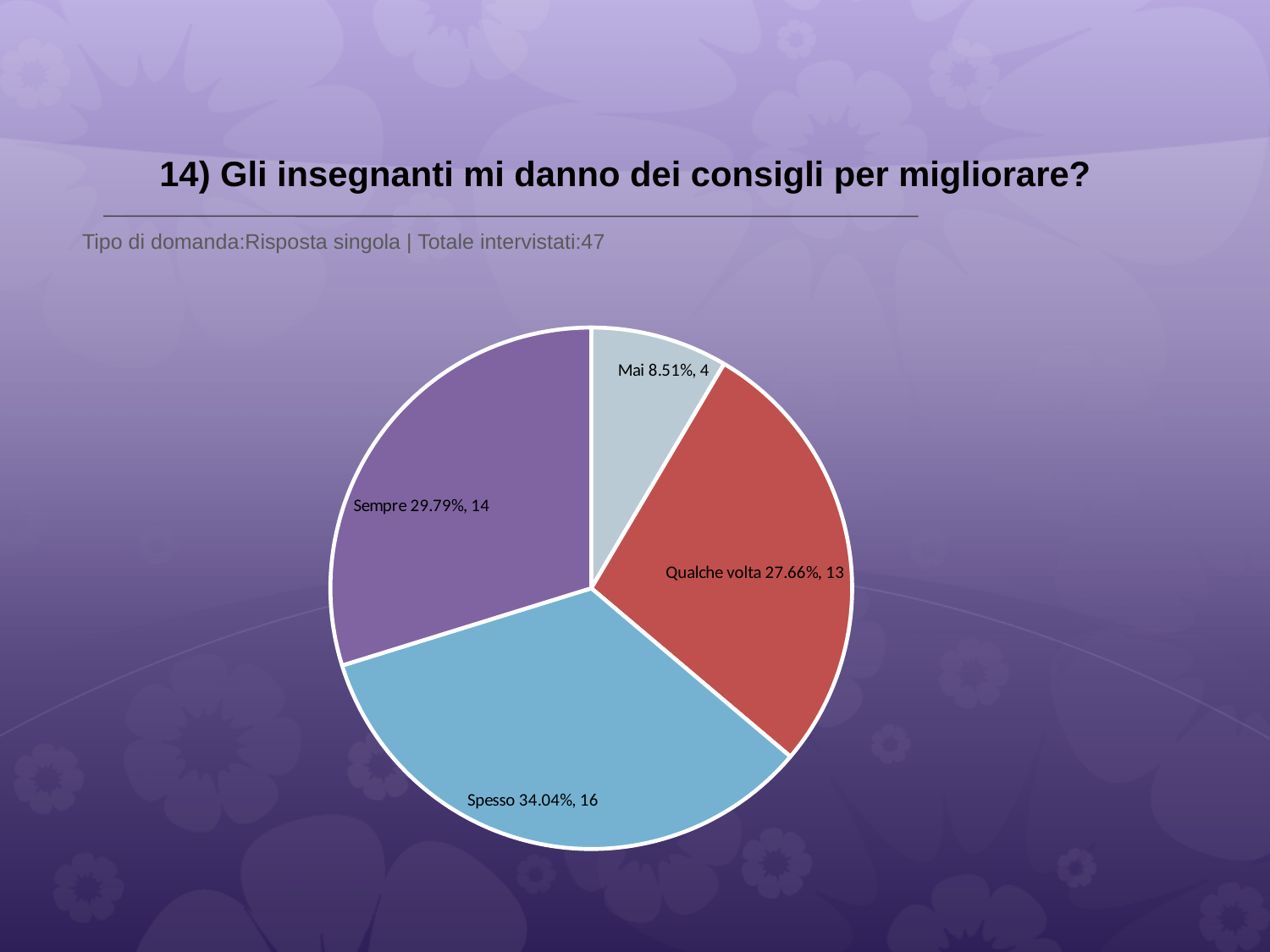
What is the title of the chart on the slide? 14) Gli insegnanti mi danno dei consigli per migliorare? What is the share of the pie for "Qualche volta"? 27.66% What percentage is shown for the "Spesso" slice? 34.04% What is the difference in respondent count between "Spesso" and "Mai"? 12 Which response has the smallest share of the pie? Mai Which has more respondents, "Sempre" or "Qualche volta"? Sempre How many respondents answered "Mai"? 4 What kind of chart is shown on the slide? pie chart How many slices does the pie chart have? 4 Which response has the largest share of the pie? Spesso How many respondents answered "Qualche volta"? 13 What percentage is shown for the "Sempre" slice? 29.79%